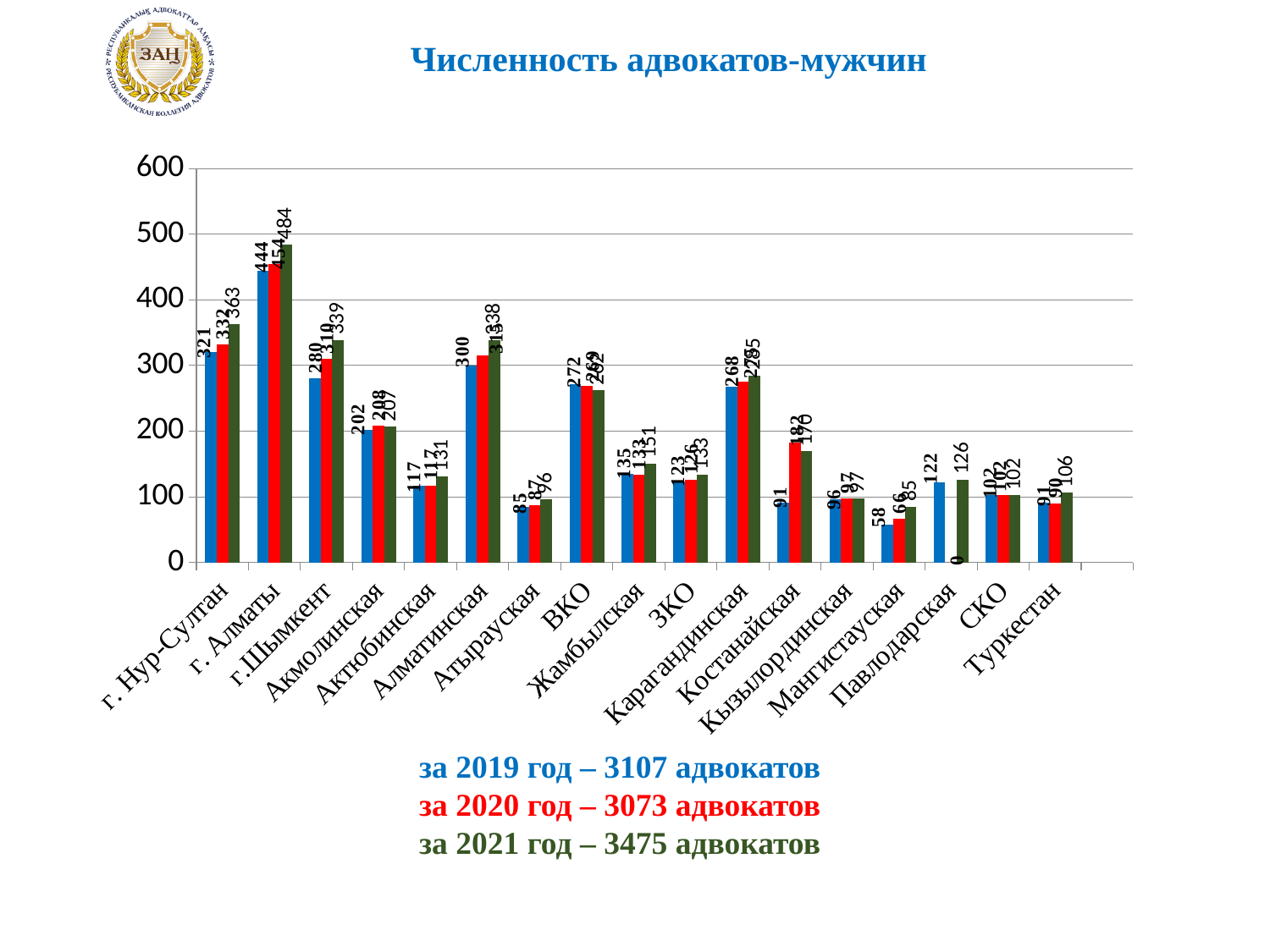
What type of chart is shown on the slide? bar chart What is the value of the green (2021) bar for Мангистауская? 85 What is the value of the blue (2019) bar for г. Нур-Султан? 321 What is the title of the chart? Численность адвокатов-мужчин What is the value of the green (2021) bar for г. Алматы? 484 How many regions (categories) are shown on the x axis of the chart? 17 Which region has the lowest blue (2019) bar? Мангистауская Which is larger: the blue (2019) bar for Алматинская or the blue (2019) bar for ВКО? Алматинская Is the value of the green (2021) bar for Жамбылская greater or less than 200? less What is the difference between the green (2021) bar and the blue (2019) bar for г.Шымкент? 59 According to the text below the chart, how many advocates were there in 2021? 3475 адвокатов Which region has the highest bar in the chart? г. Алматы